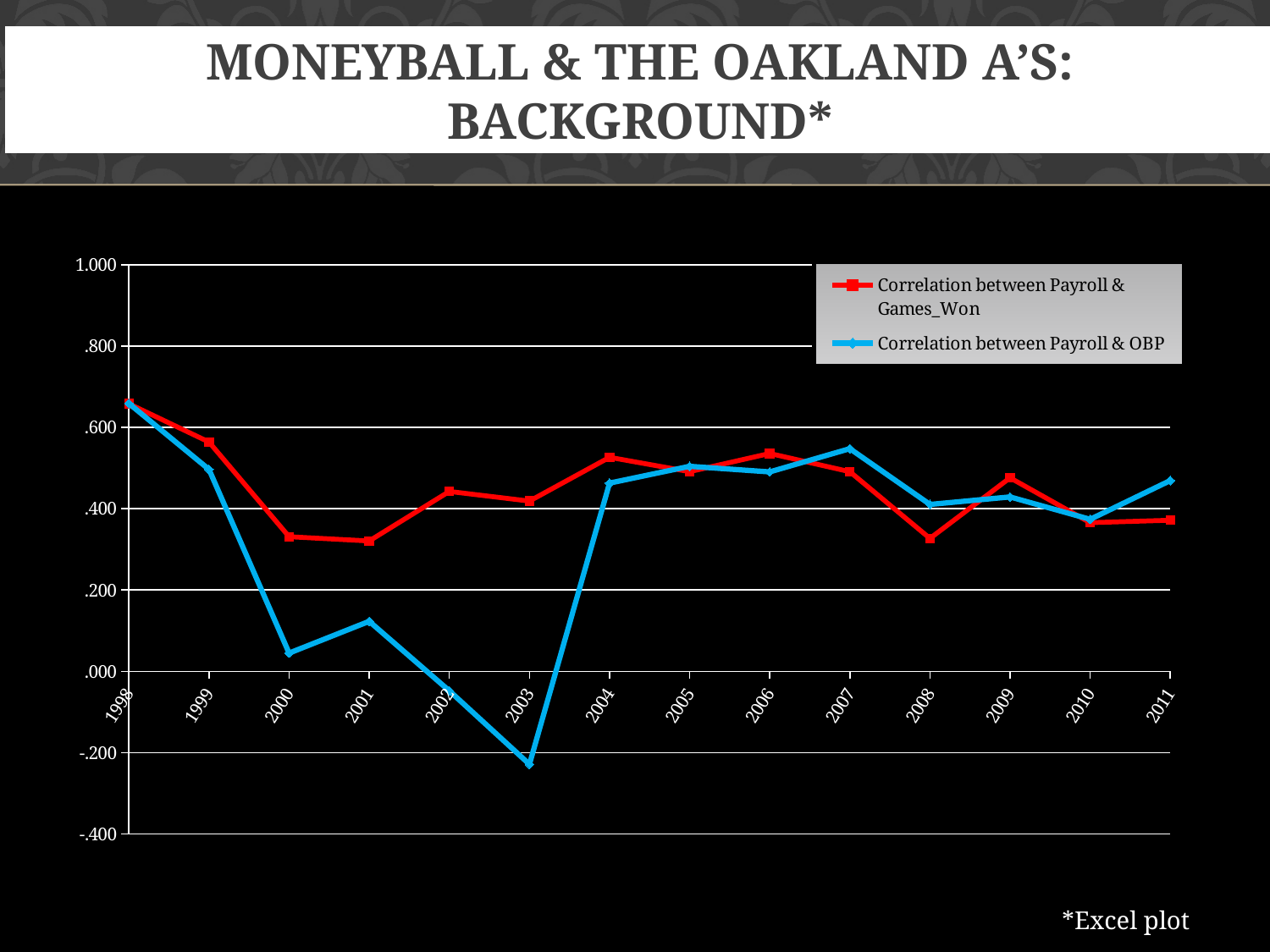
Is the value for Correlation between Payroll & Games_Won in 2004 greater or less than .400? greater In 2000, which series has the larger value: Correlation between Payroll & Games_Won or Correlation between Payroll & OBP? Correlation between Payroll & Games_Won How many series does the legend list? 2 Is the value for Correlation between Payroll & OBP in 2000 greater or less than .200? less Which year has the lowest value for Correlation between Payroll & OBP? 2003 What kind of chart is shown on the slide? Line chart Does the Correlation between Payroll & OBP series rise or fall from 1998 to 2003? Fall In 2011, which series has the larger value: Correlation between Payroll & Games_Won or Correlation between Payroll & OBP? Correlation between Payroll & OBP Which year has the highest value for Correlation between Payroll & Games_Won? 1998 Which year has the highest value for Correlation between Payroll & OBP? 1998 Is the value for Correlation between Payroll & OBP in 2003 greater or less than .000? less How many years are plotted along the x axis? 14